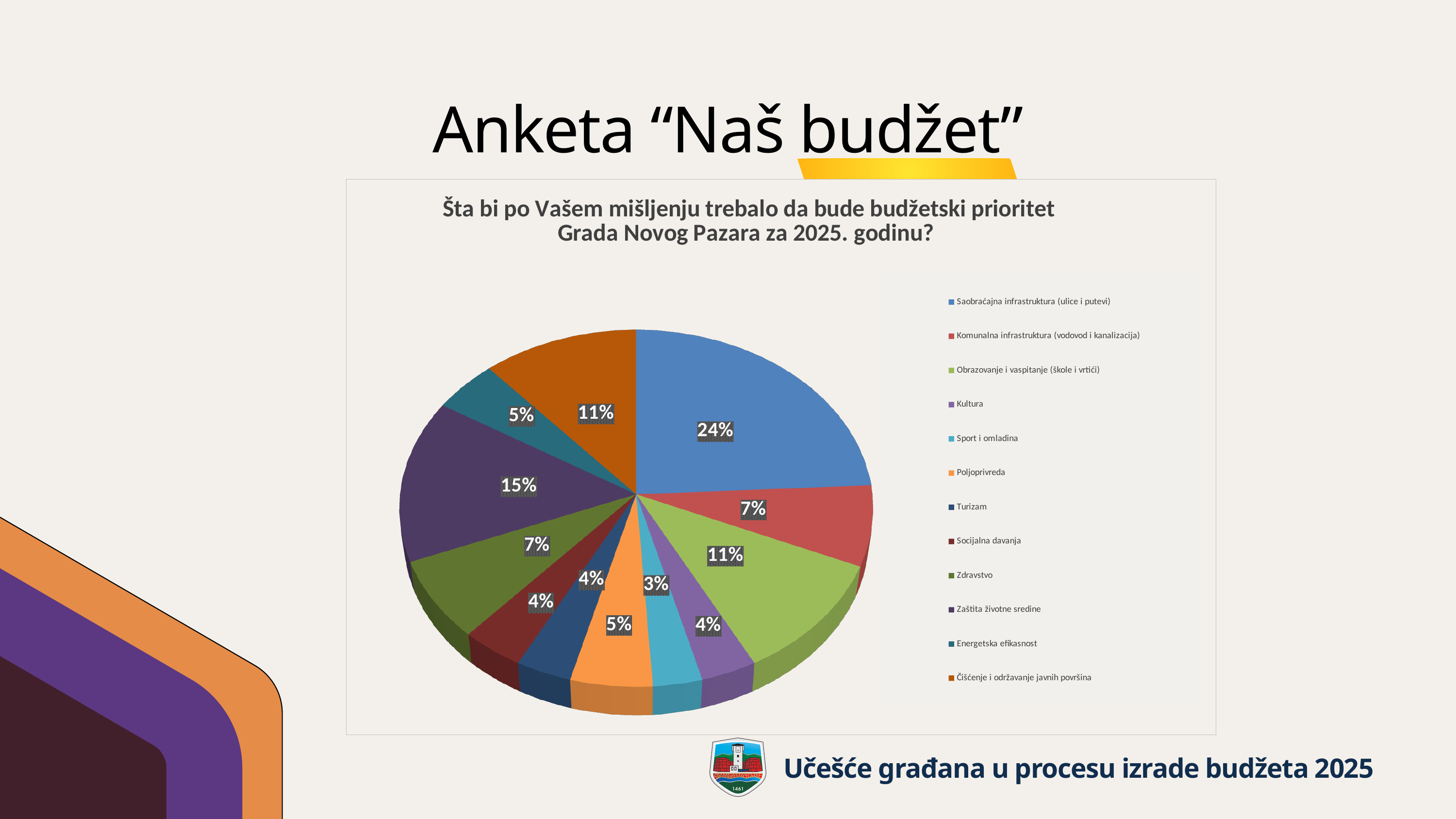
What share of the pie does Sport i omladina have? 3% What share of the pie does Obrazovanje i vaspitanje (škole i vrtići) have? 11% How many categories does the legend list? 12 Which category has the largest share of the pie? Saobraćajna infrastruktura (ulice i putevi) What kind of chart is shown on the slide? pie chart What is the title of the chart? Šta bi po Vašem mišljenju trebalo da bude budžetski prioritet Grada Novog Pazara za 2025. godinu? Which has a larger share: Zdravstvo or Poljoprivreda? Zdravstvo What share of the pie does Zaštita životne sredine have? 15% What share of the pie does Saobraćajna infrastruktura (ulice i putevi) have? 24% Which category has the smallest share of the pie? Sport i omladina What is the difference between the shares of Saobraćajna infrastruktura (ulice i putevi) and Zaštita životne sredine? 9% What share of the pie does Čišćenje i održavanje javnih površina have? 11%